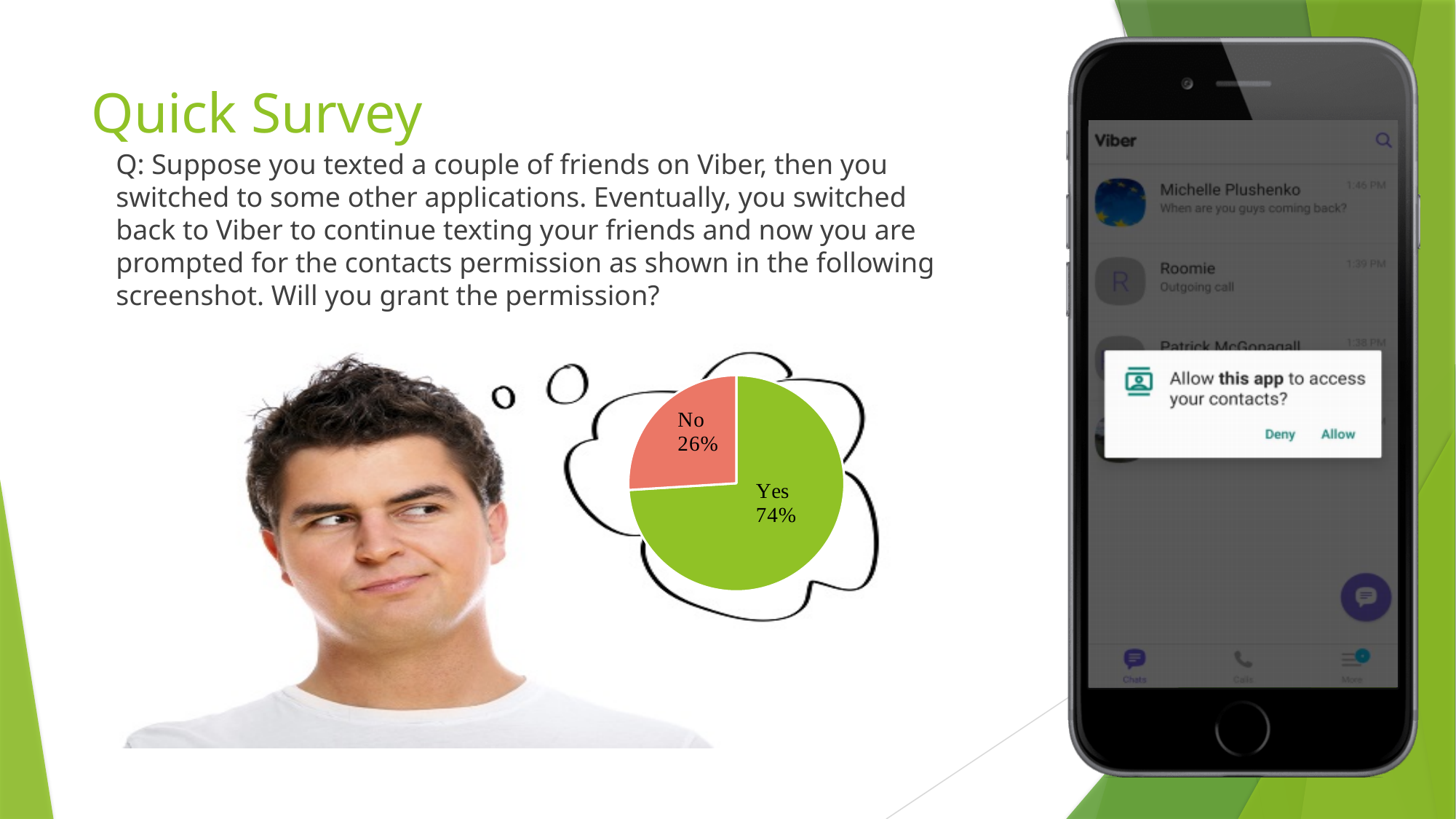
Which response has the smallest share of the pie? No What percentage of respondents answered No? 26% What colour is the No slice of the pie chart? red What colour is the Yes slice of the pie chart? green What kind of chart is shown inside the thought bubble? pie chart What share of the pie does the No slice represent? 26% What is the difference in percentage points between the Yes and No slices? 48 How many slices does the pie chart have? 2 Which response has the largest share of the pie? Yes What percentage of respondents answered Yes? 74% Which slice is larger, Yes or No? Yes